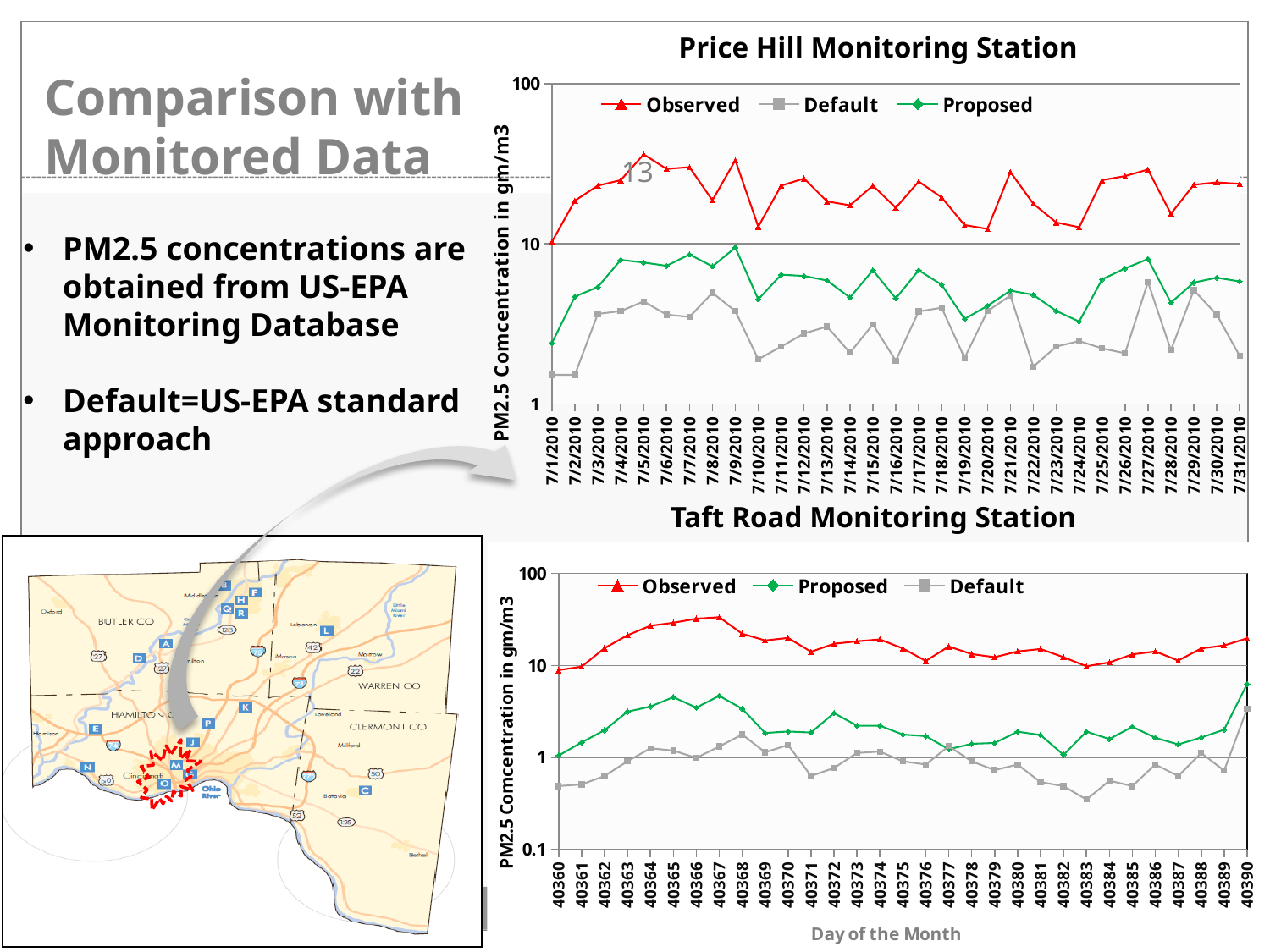
In the Price Hill Monitoring Station chart, is the Observed value on 7/5/2010 greater or less than 10? greater What kind of chart is the Price Hill Monitoring Station chart? line chart In the Taft Road Monitoring Station chart, is the Observed value on day 40367 greater or less than 10? greater In the Taft Road Monitoring Station chart, on which day is the Default series at its lowest? 40383 How many series does the legend of the Taft Road Monitoring Station chart list? 3 In the Price Hill Monitoring Station chart, is the Default value on 7/1/2010 greater or less than 1? greater In the Price Hill Monitoring Station chart, which is larger on 7/5/2010, the Observed value or the Default value? Observed What is the y-axis label of the Taft Road Monitoring Station chart? PM2.5 Comcentration in gm/m3 In the Taft Road Monitoring Station chart, which is larger on day 40390, the Proposed value or the Default value? Proposed In the Taft Road Monitoring Station chart, how many days are plotted along the x axis? 31 In the Price Hill Monitoring Station chart, how many dates are plotted along the x axis? 31